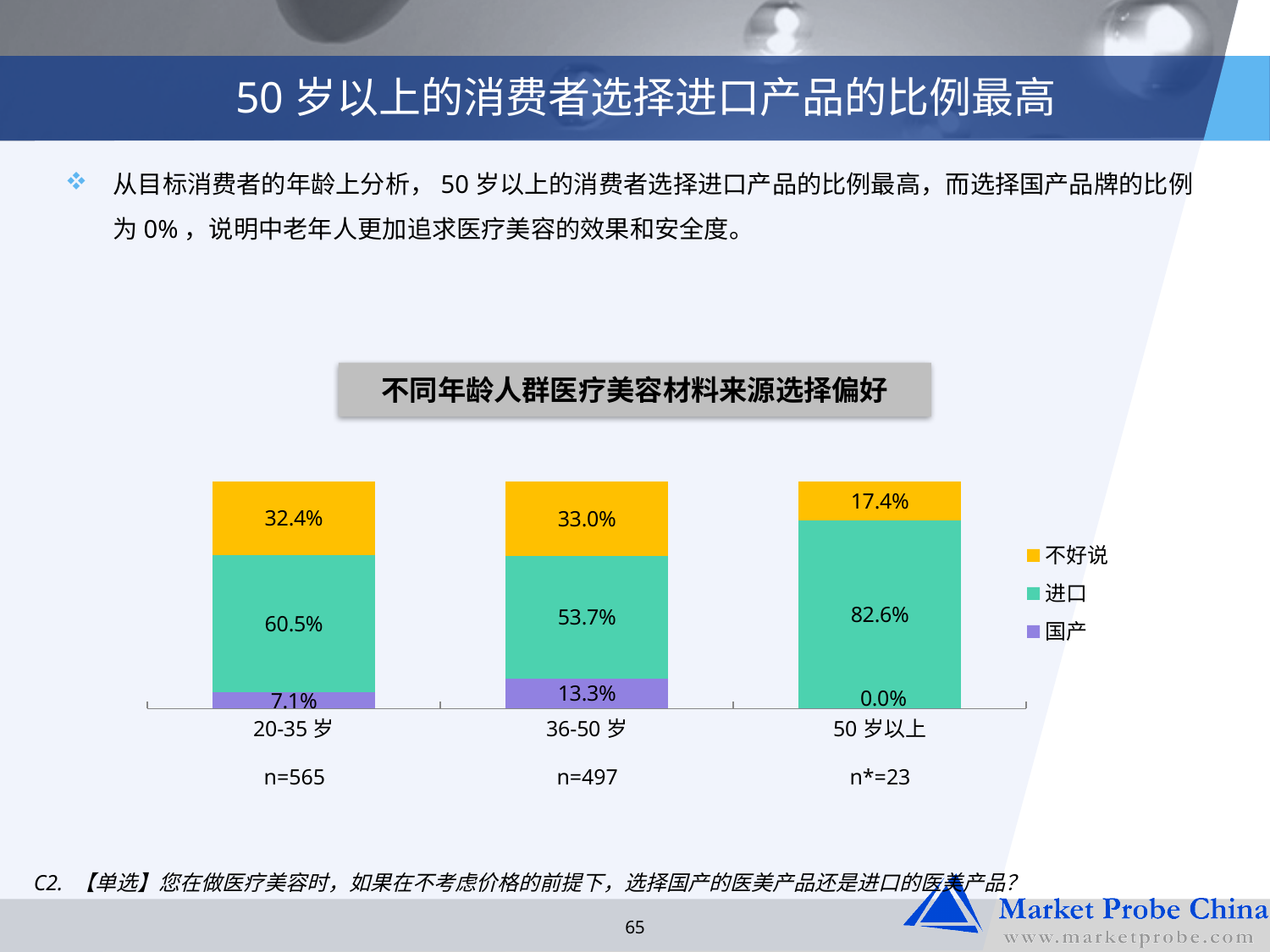
What is the value for 进口 in the 50 岁以上 group? 82.6% What is the value for 不好说 in the 20-35 岁 group? 32.4% Which age group has the highest value for 进口? 50 岁以上 How many series does the legend list? 3 How many age groups are shown on the x axis? 3 What kind of chart is shown on the slide? Stacked bar chart What is the total of the stacked bar for 36-50 岁? 100.0% Which is larger, the 不好说 value for 20-35 岁 or for 50 岁以上? 20-35 岁 What is the value for 国产 in the 36-50 岁 group? 13.3% What is the difference between the 进口 values for 50 岁以上 and 36-50 岁? 28.9% Which age group has the lowest value for 国产? 50 岁以上 What is the title of the chart? 不同年龄人群医疗美容材料来源选择偏好